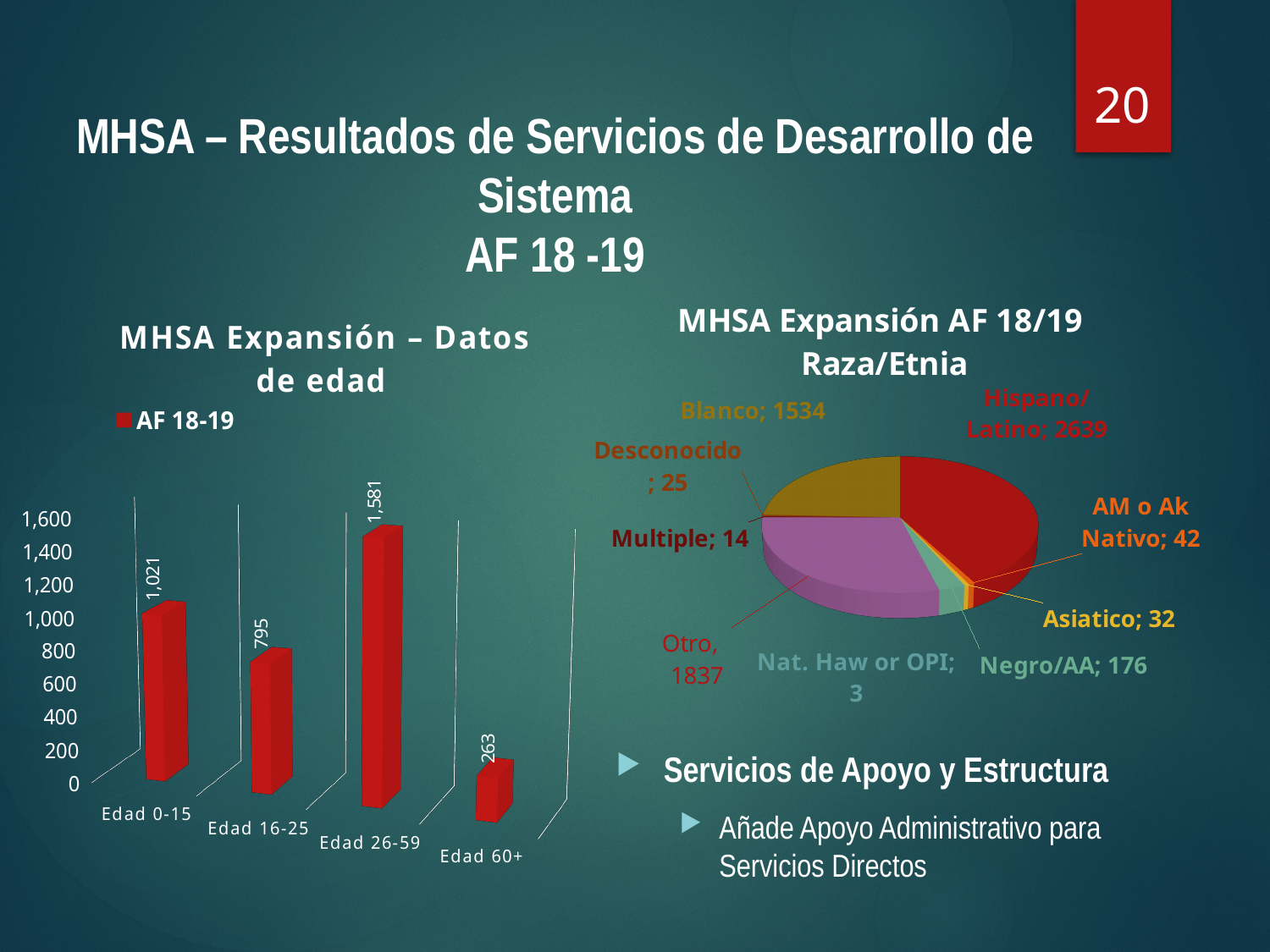
In the chart 'MHSA Expansión – Datos de edad', what is the value for Edad 60+? 263 In the pie chart 'MHSA Expansión AF 18/19 Raza/Etnia', which is larger, Blanco or Otro? Otro In the pie chart 'MHSA Expansión AF 18/19 Raza/Etnia', which category has the largest value? Hispano/Latino In the chart 'MHSA Expansión – Datos de edad', which age category has the lowest value? Edad 60+ What kind of chart is 'MHSA Expansión – Datos de edad'? Bar chart In the chart 'MHSA Expansión – Datos de edad', which age category has the highest value? Edad 26-59 In the chart 'MHSA Expansión – Datos de edad', what is the value for Edad 26-59? 1,581 In the chart 'MHSA Expansión – Datos de edad', what is the difference between the values for Edad 26-59 and Edad 0-15? 560 In the pie chart 'MHSA Expansión AF 18/19 Raza/Etnia', what is the value for Negro/AA? 176 In the chart 'MHSA Expansión – Datos de edad', how many age categories are shown? 4 In the chart 'MHSA Expansión – Datos de edad', what series name does the legend show? AF 18-19 In the pie chart 'MHSA Expansión AF 18/19 Raza/Etnia', which category has the smallest value? Nat. Haw or OPI